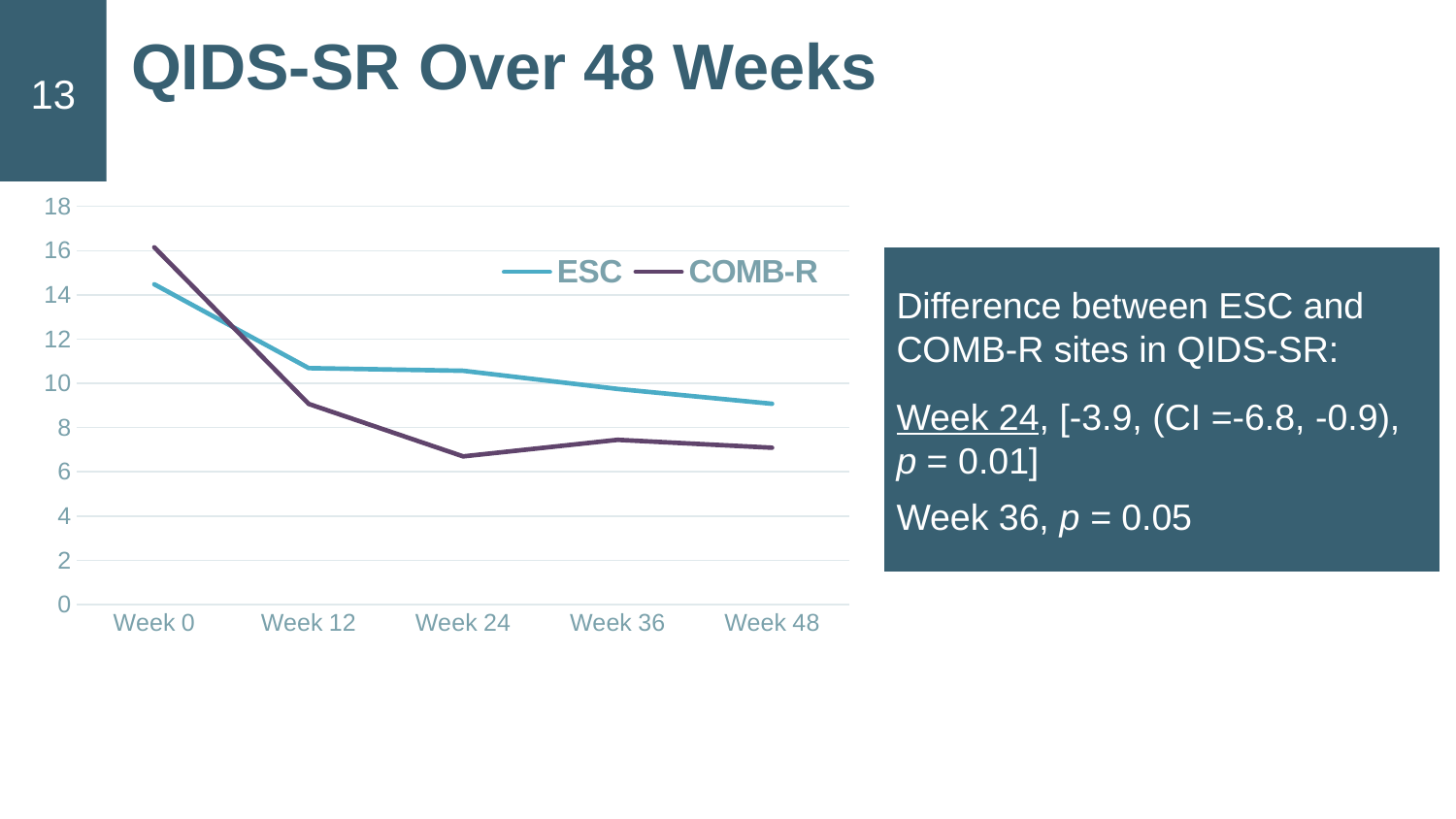
How many time points are plotted along the x axis? 5 Do the ESC values rise or fall from Week 0 to Week 48? Fall Is the COMB-R value at Week 24 greater or less than 8? less Is the ESC value at Week 48 greater or less than 10? less What kind of chart is shown on the slide? Line chart How many series does the legend list? 2 What is the title of the chart? QIDS-SR Over 48 Weeks At which week is the ESC series at its highest value? Week 0 Is the ESC value at Week 0 greater or less than 14? greater At Week 0, which series has the higher value, ESC or COMB-R? COMB-R At Week 24, which series has the higher value, ESC or COMB-R? ESC Which two series are listed in the legend? ESC and COMB-R